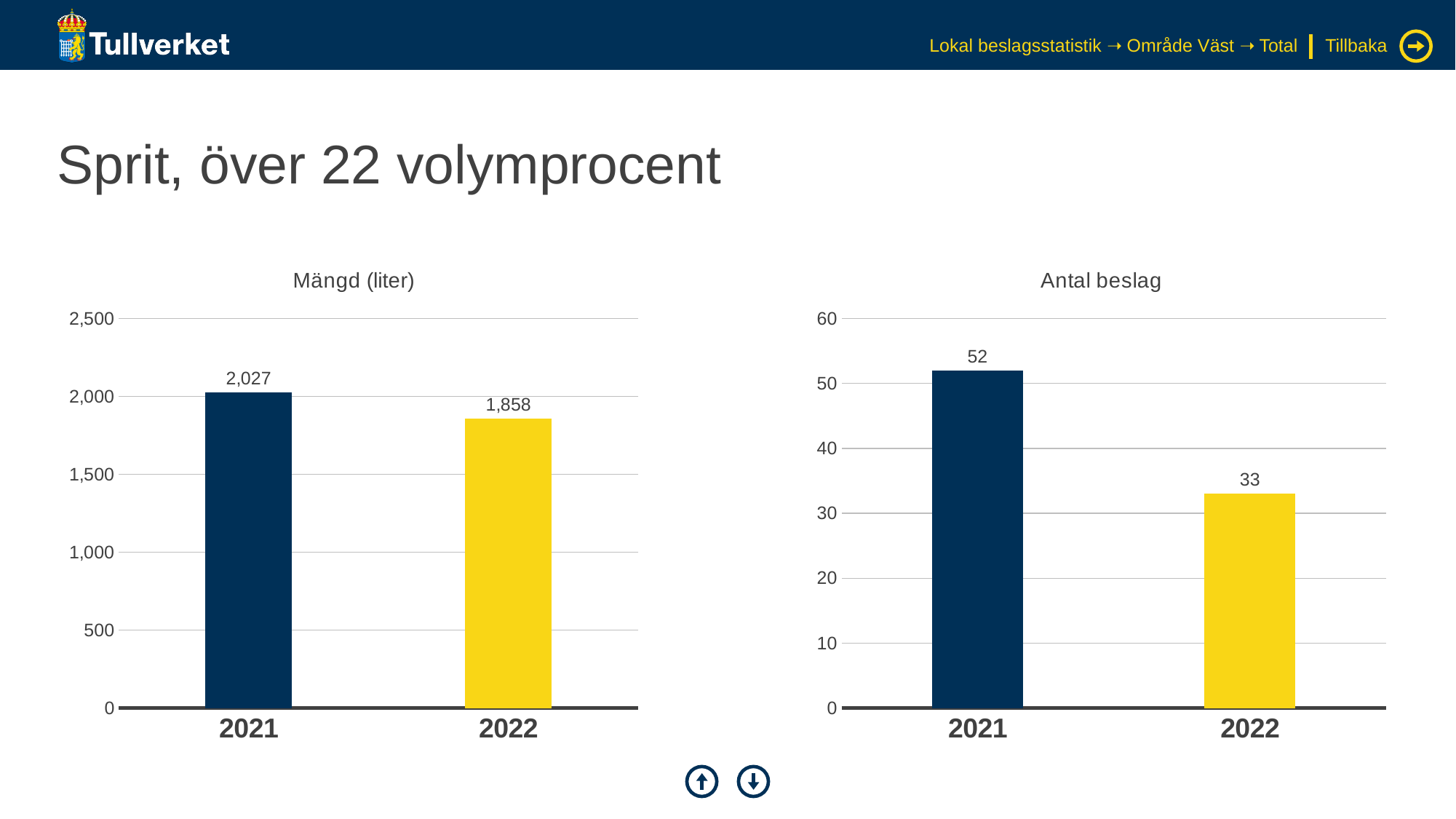
In the "Mängd (liter)" chart, how many bars are plotted? 2 In the "Mängd (liter)" chart, what is the value for 2022? 1,858 In the "Mängd (liter)" chart, do the values rise or fall from 2021 to 2022? fall In the "Mängd (liter)" chart, what is the difference between the 2021 and 2022 values? 169 In the "Antal beslag" chart, what is the difference between the 2021 and 2022 values? 19 In the "Antal beslag" chart, which year has the lowest value? 2022 In the "Antal beslag" chart, what is the value for 2022? 33 In the "Mängd (liter)" chart, what is the value for 2021? 2,027 In the "Antal beslag" chart, is the value for 2021 larger or smaller than the value for 2022? larger What kind of chart is the "Antal beslag" chart? bar chart In the "Antal beslag" chart, what is the value for 2021? 52 In the "Mängd (liter)" chart, which year has the highest value? 2021